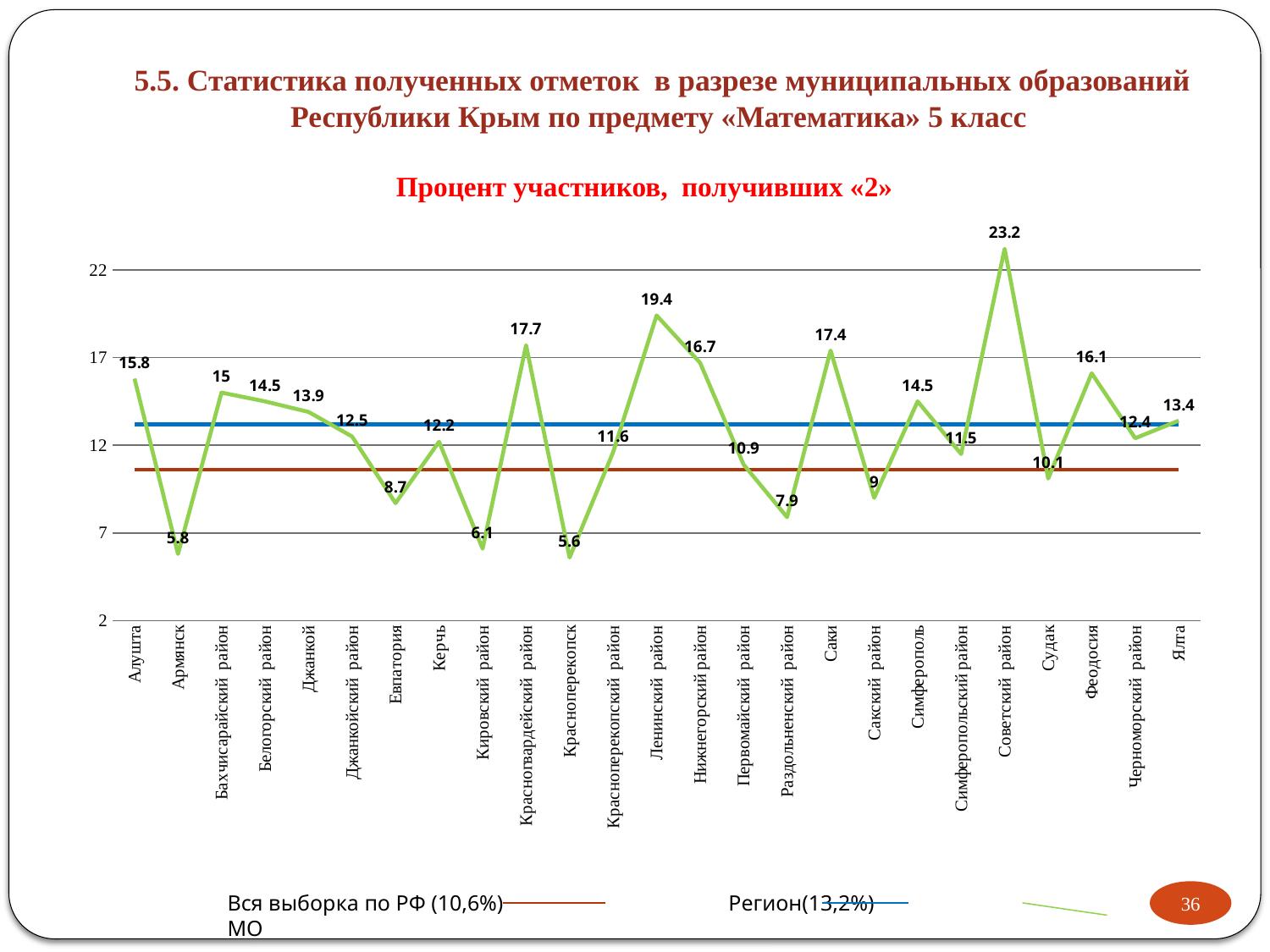
What is the value shown for Армянск? 5.8 Which municipality has the highest percentage of participants who received a "2"? Советский район What is the percentage of participants who received a "2" in Советский район? 23.2 How many municipalities are plotted along the x axis? 25 What is the value shown for Ленинский район? 19.4 What is the difference between the values for Советский район and Красноперекопск? 17.6 Is the value for Евпатория greater or less than 12? less What value does the legend give for the "Вся выборка по РФ" reference line? 10,6% How many series does the legend list? 3 Which municipality has the lowest percentage of participants who received a "2"? Красноперекопск What kind of chart is shown on the slide? line chart Which has a higher value, Саки or Симферополь? Саки